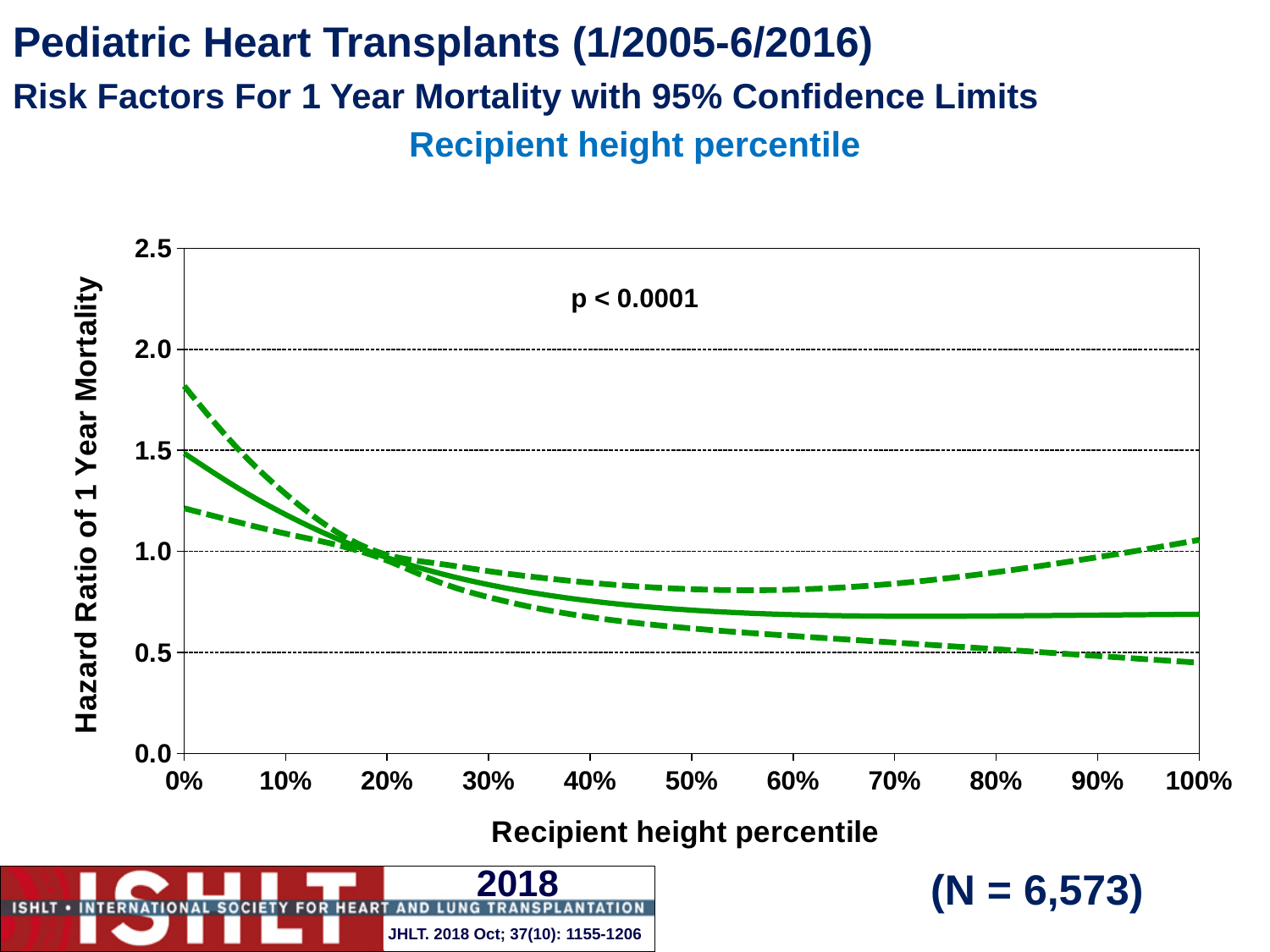
What is the label of the y axis? Hazard Ratio of 1 Year Mortality What p-value is printed on the chart? p < 0.0001 Is the solid hazard ratio line at 0% recipient height percentile greater or less than 1.0? greater Is the upper dashed confidence limit at 0% recipient height percentile greater or less than 1.5? greater Is the solid hazard ratio line at 100% recipient height percentile greater or less than 1.0? less How many tick labels are shown on the x axis (Recipient height percentile)? 11 Does the solid hazard ratio line rise or fall between 0% and 50% recipient height percentile? fall Is the solid hazard ratio line higher at 0% or at 100% recipient height percentile? 0% What kind of chart is shown on the slide? line chart What is the highest value labelled on the y axis? 2.5 How many lines are plotted on the chart? 3